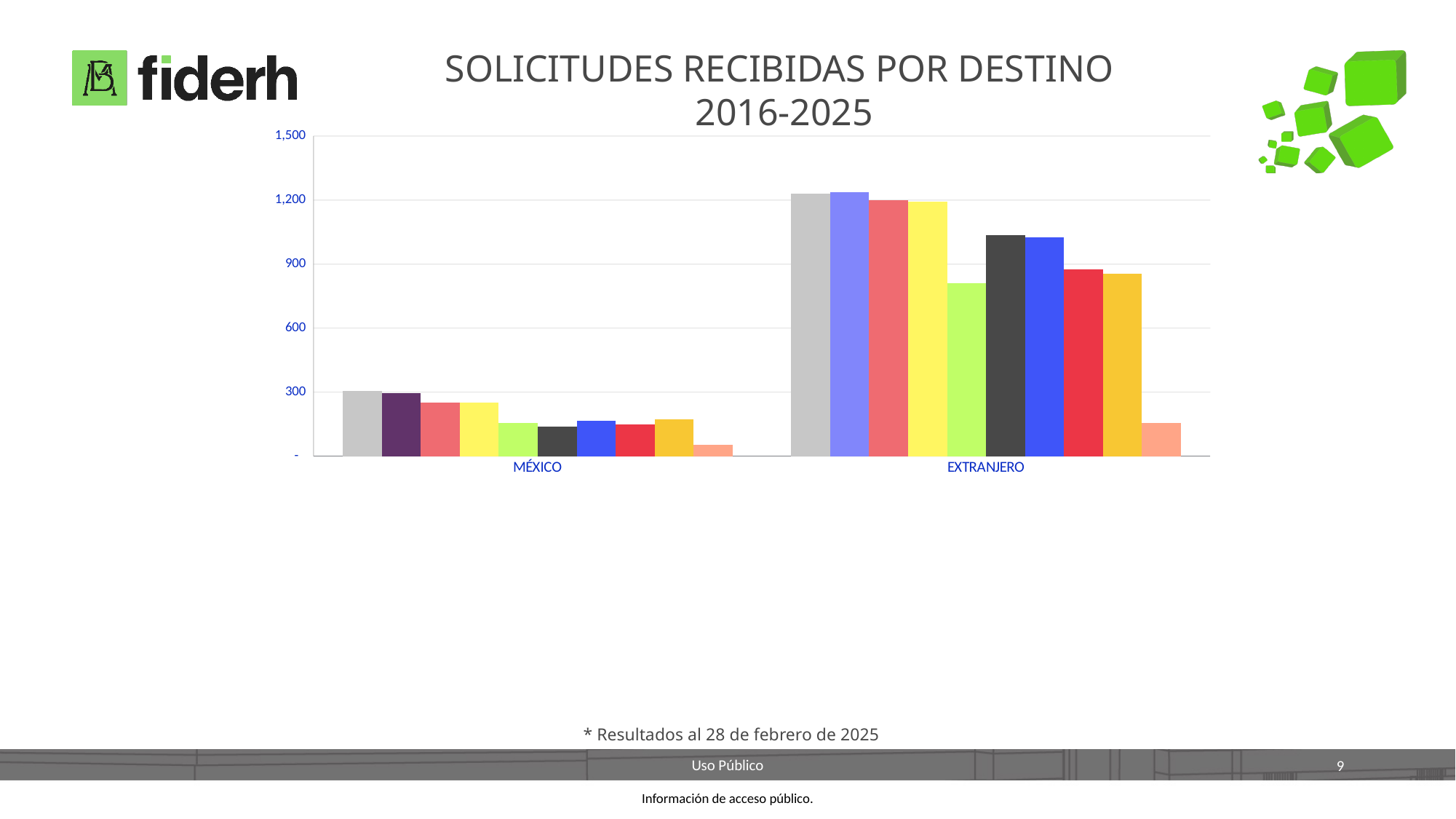
Is the tallest bar in the EXTRANJERO group greater or less than 900? greater What is the highest value shown on the y axis of the chart? 1,500 Is the shortest bar in the EXTRANJERO group greater or less than 300? less Is the tallest bar in the EXTRANJERO group greater or less than 1,500? less What are the two categories on the x axis of the chart? MÉXICO and EXTRANJERO How many categories are shown on the x axis of the chart? 2 Which category has the taller bars overall, MÉXICO or EXTRANJERO? EXTRANJERO How many bars are plotted in the MÉXICO group? 10 How many bars are plotted in the EXTRANJERO group? 10 What kind of chart is shown on the slide? bar chart What is the title of the chart? SOLICITUDES RECIBIDAS POR DESTINO 2016-2025